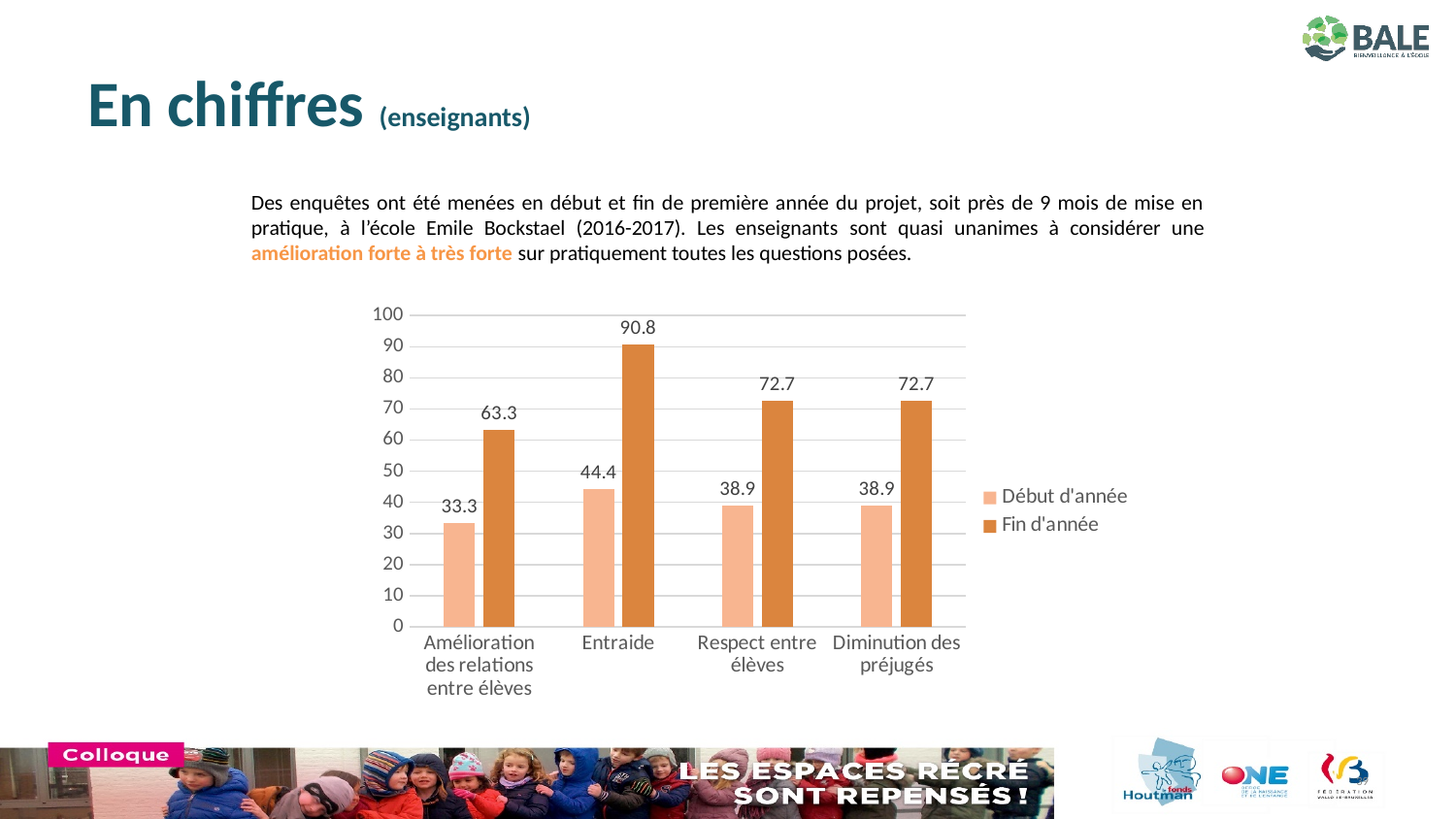
Which category has the highest 'Fin d'année' value? Entraide What kind of chart is shown on the slide? Bar chart How many categories are shown on the x axis? 4 What is the value for 'Respect entre élèves' in the 'Fin d'année' series? 72.7 What is the difference between the 'Fin d'année' and 'Début d'année' values for 'Amélioration des relations entre élèves'? 30 Which category has the lowest 'Début d'année' value? Amélioration des relations entre élèves Is the 'Fin d'année' value for 'Diminution des préjugés' greater or less than 70? greater What is the difference between the 'Fin d'année' and 'Début d'année' values for 'Entraide'? 46.4 Which is larger: the 'Début d'année' value for 'Entraide' or the 'Début d'année' value for 'Respect entre élèves'? Entraide How many series does the legend list? 2 What is the value for 'Entraide' in the 'Fin d'année' series? 90.8 What is the value for 'Amélioration des relations entre élèves' in the 'Début d'année' series? 33.3